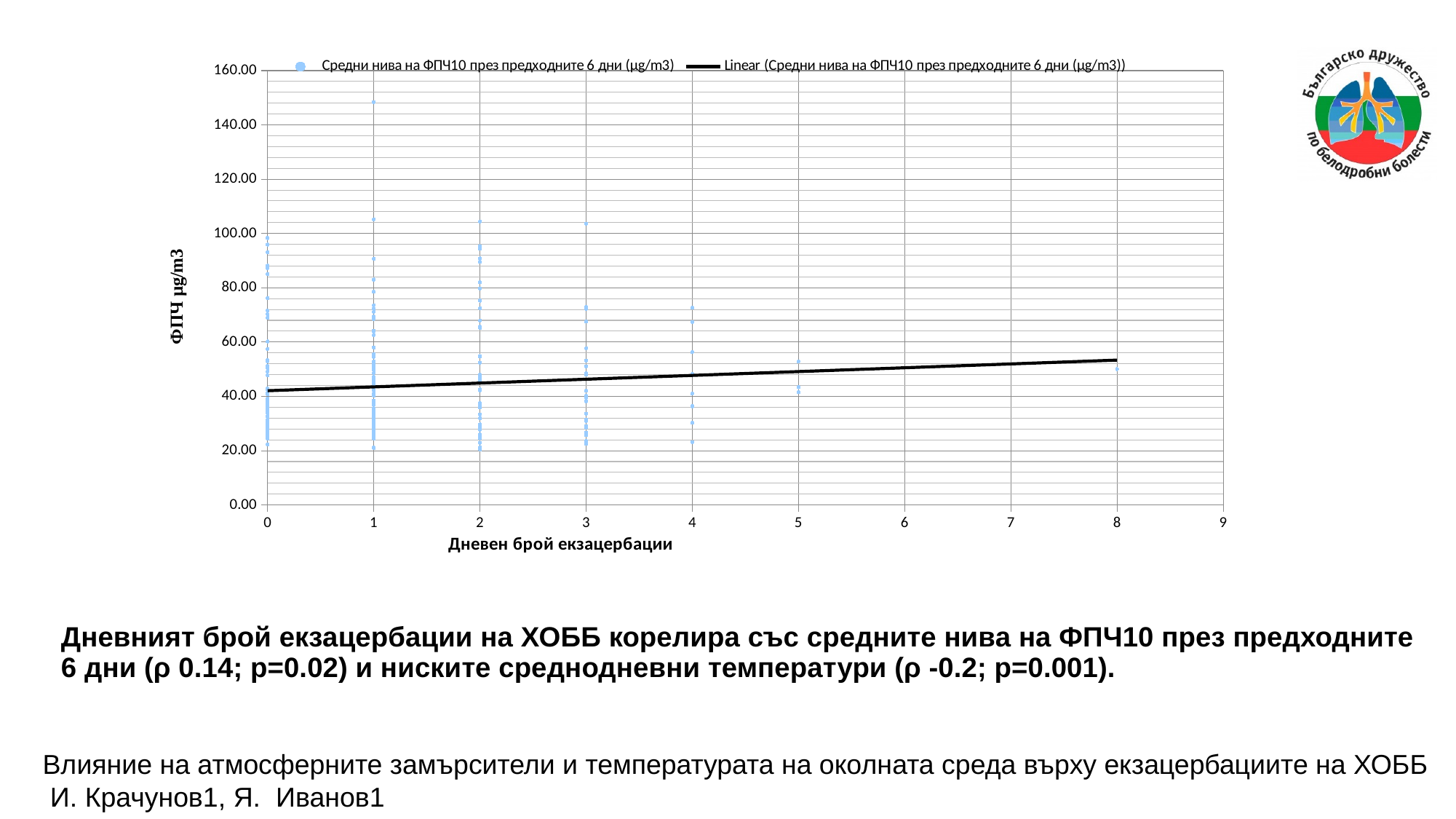
Is the highest plotted point at x = 5 greater or less than 60? less Is the value of the linear trendline at x = 8 greater or less than 60? less Are the plotted PM10 values at x = 8 greater or less than 60? less How many distinct x-axis values have plotted data points? 7 At which daily number of exacerbations does the single highest PM10 point appear? 1 What is the title of the x axis? Дневен брой екзацербации How many entries does the chart legend list? 2 What kind of chart is shown on the slide? scatter plot Does the linear trendline rise or fall as the daily number of exacerbations increases? rises What is the maximum value shown on the y axis? 160.00